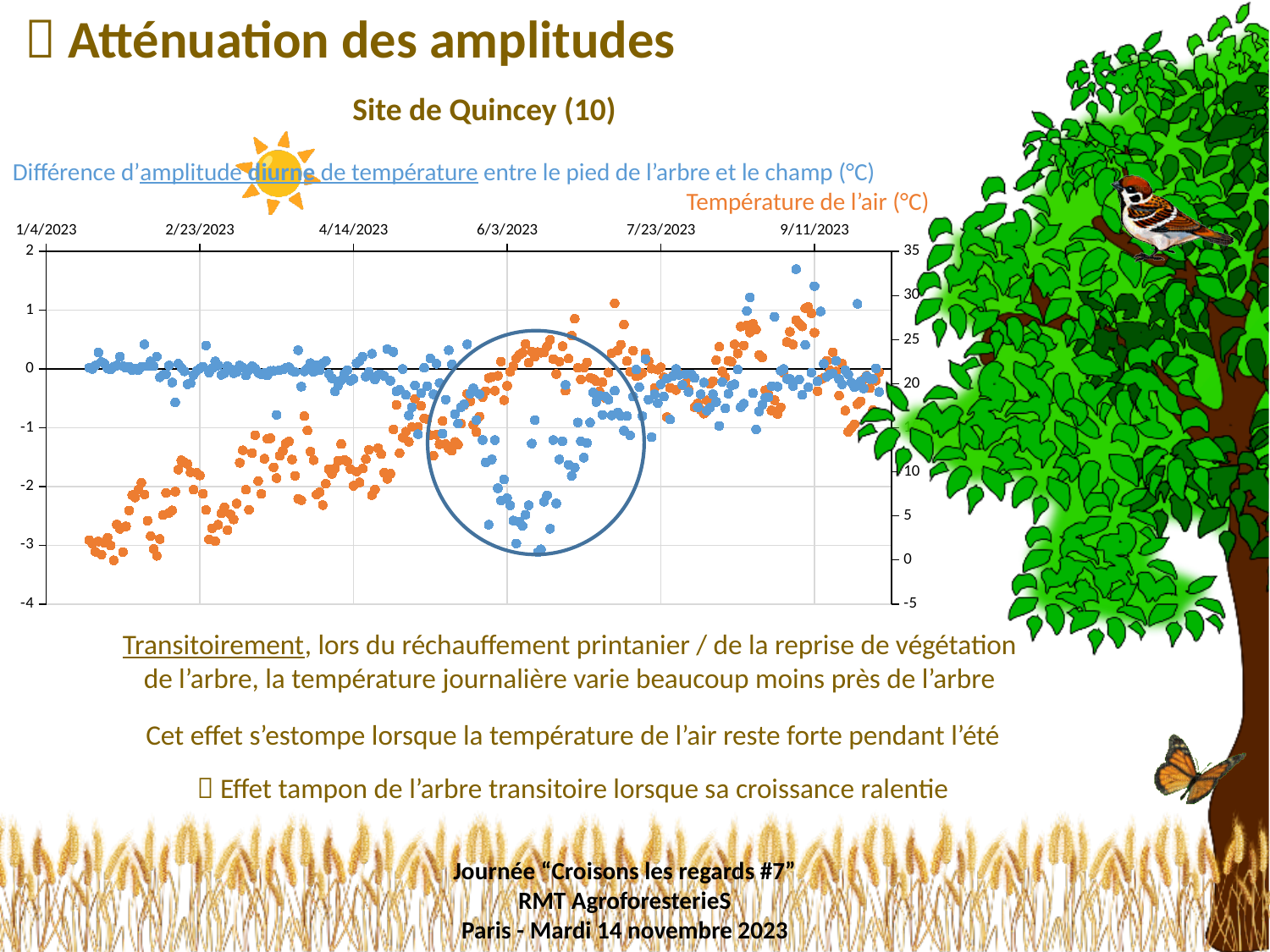
How many date labels are shown on the horizontal axis of the chart? 6 Does the orange air temperature series rise or fall between 1/4/2023 and 7/23/2023? Rise What is the first date label on the horizontal axis of the chart? 1/4/2023 How many data series are plotted on the chart? 2 Which series is plotted in blue on the chart? Différence d'amplitude diurne de température entre le pied de l'arbre et le champ (°C) Which series is plotted in orange on the chart? Température de l'air (°C) What is the lowest value shown on the left vertical axis of the chart? -4 What is the last date label on the horizontal axis of the chart? 9/11/2023 What is the lowest value shown on the right vertical axis of the chart? -5 What is the highest value shown on the left vertical axis of the chart? 2 What is the highest value shown on the right vertical axis of the chart? 35 What kind of chart is shown on the slide? Scatter chart